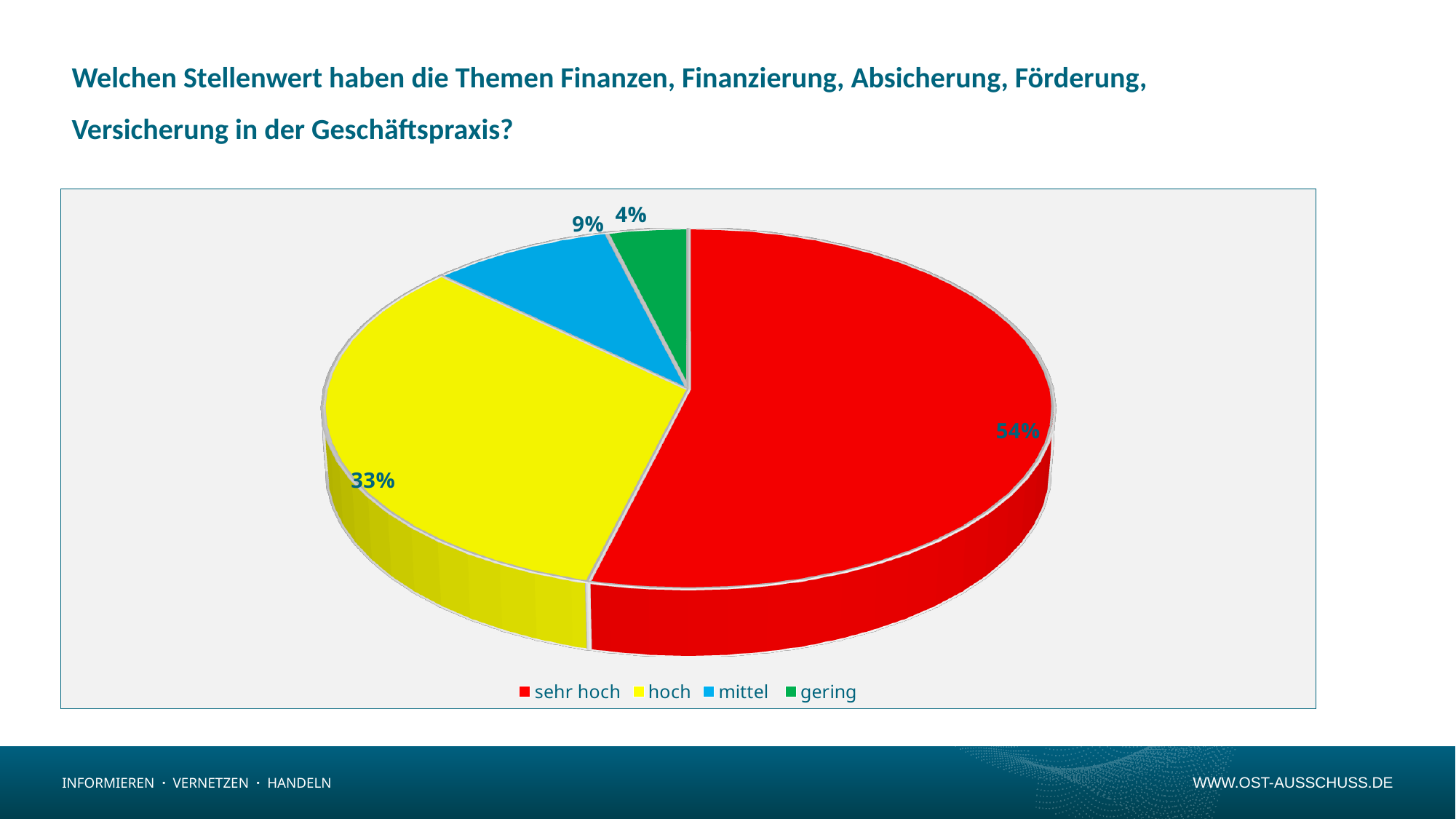
Which category has the largest slice? sehr hoch What is the value for "hoch"? 33% What share of the pie does "sehr hoch" have? 54% How many categories does the pie chart show? 4 Which is larger, the value for "mittel" or the value for "gering"? mittel What is the value for "gering"? 4% What colour is the "hoch" slice? yellow What is the value for "mittel"? 9% What is the difference between the values for "sehr hoch" and "hoch"? 21% Which legend entry is shown in green? gering Which category has the smallest slice? gering What kind of chart is shown on the slide? pie chart